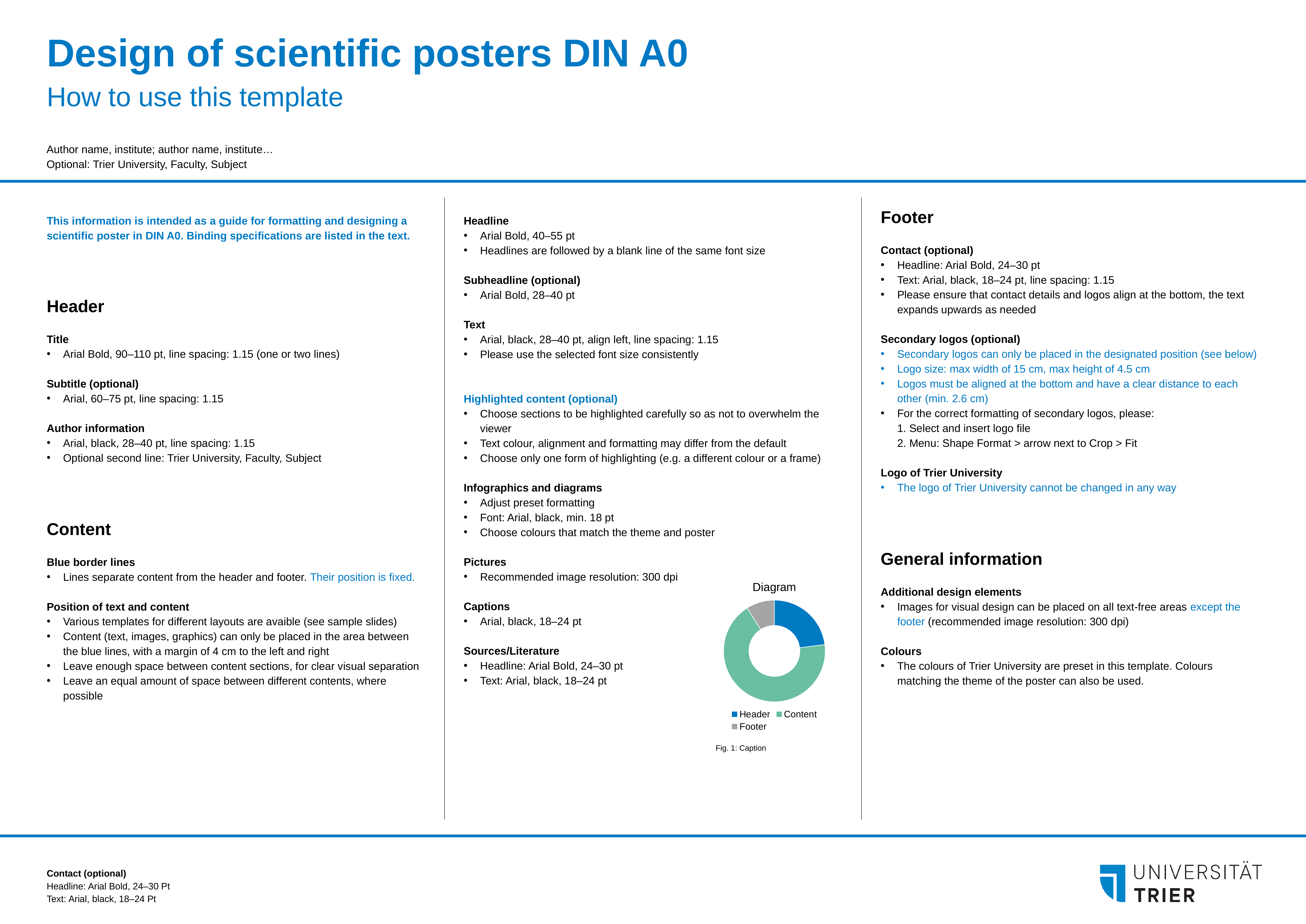
What colour is the Header slice in the "Diagram" chart? Blue Which category has the smallest slice in the "Diagram" chart? Footer In the "Diagram" chart, which slice is larger, Header or Footer? Header What is the title of the chart on the slide? Diagram In the "Diagram" chart, which slice is larger, Header or Content? Content How many categories does the "Diagram" chart show? 3 Which category has the largest slice in the "Diagram" chart? Content How many entries does the legend of the "Diagram" chart list? 3 What kind of chart is shown under the title "Diagram"? Doughnut chart